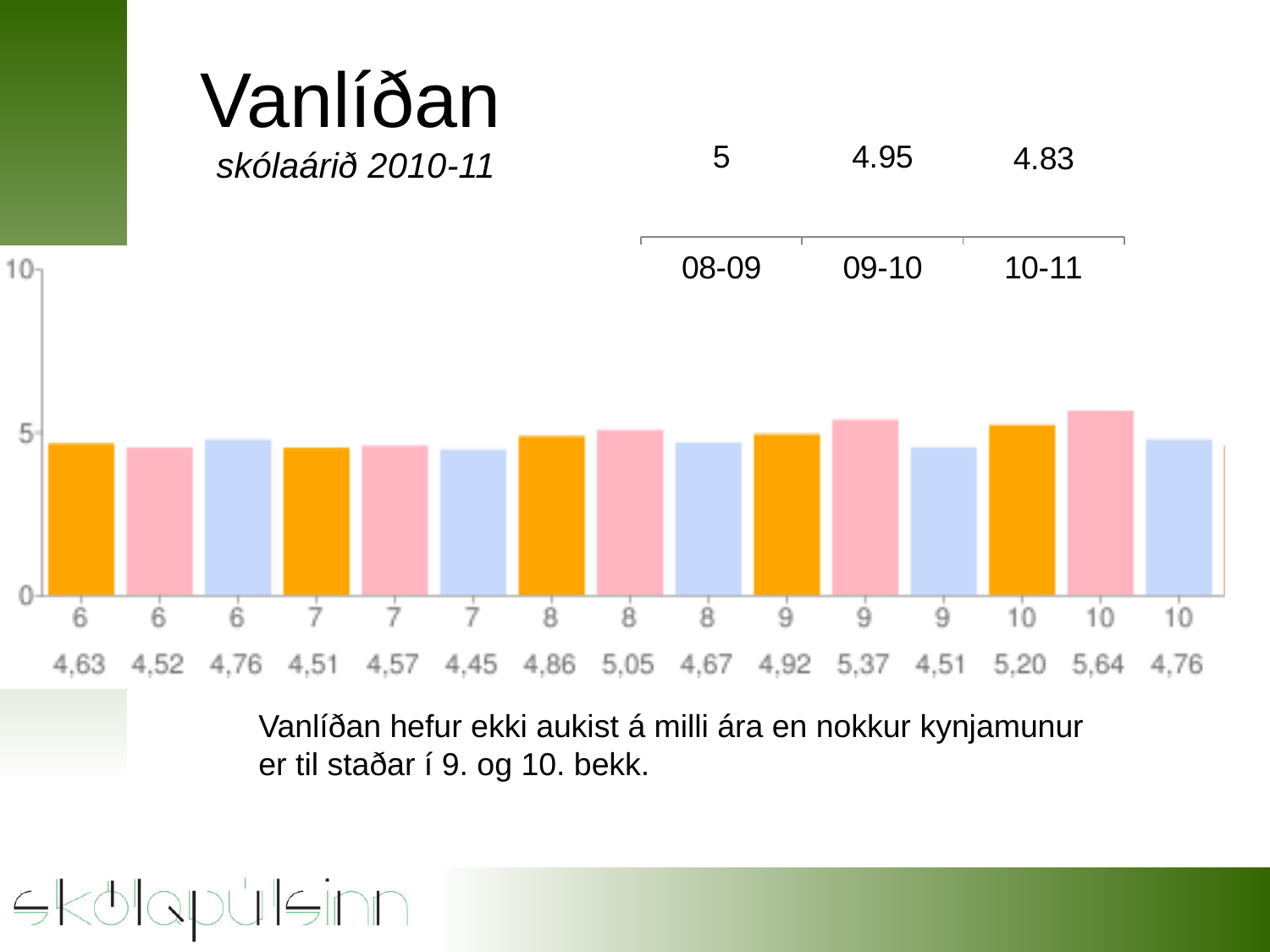
What is the difference between the pink bar and the blue bar for grade 10? 0,88 What is the value of the pink bar for grade 9? 5,37 In the small table above the chart, what value is given for 09-10? 4.95 In the small table above the chart, what is the difference between the 08-09 value and the 10-11 value? 0.17 Is the value of the pink bar for grade 10 greater or less than 5? greater Which bar has the highest value in the chart? the pink bar for grade 10 (5,64) Which is larger, the orange bar for grade 8 or the orange bar for grade 9? the orange bar for grade 9 What is the highest tick value shown on the y axis? 10 How many bars are plotted in the chart? 15 What is the value of the orange bar for grade 6? 4,63 Which bar has the lowest value in the chart? the blue bar for grade 7 (4,45) What kind of chart is shown on the slide? bar chart